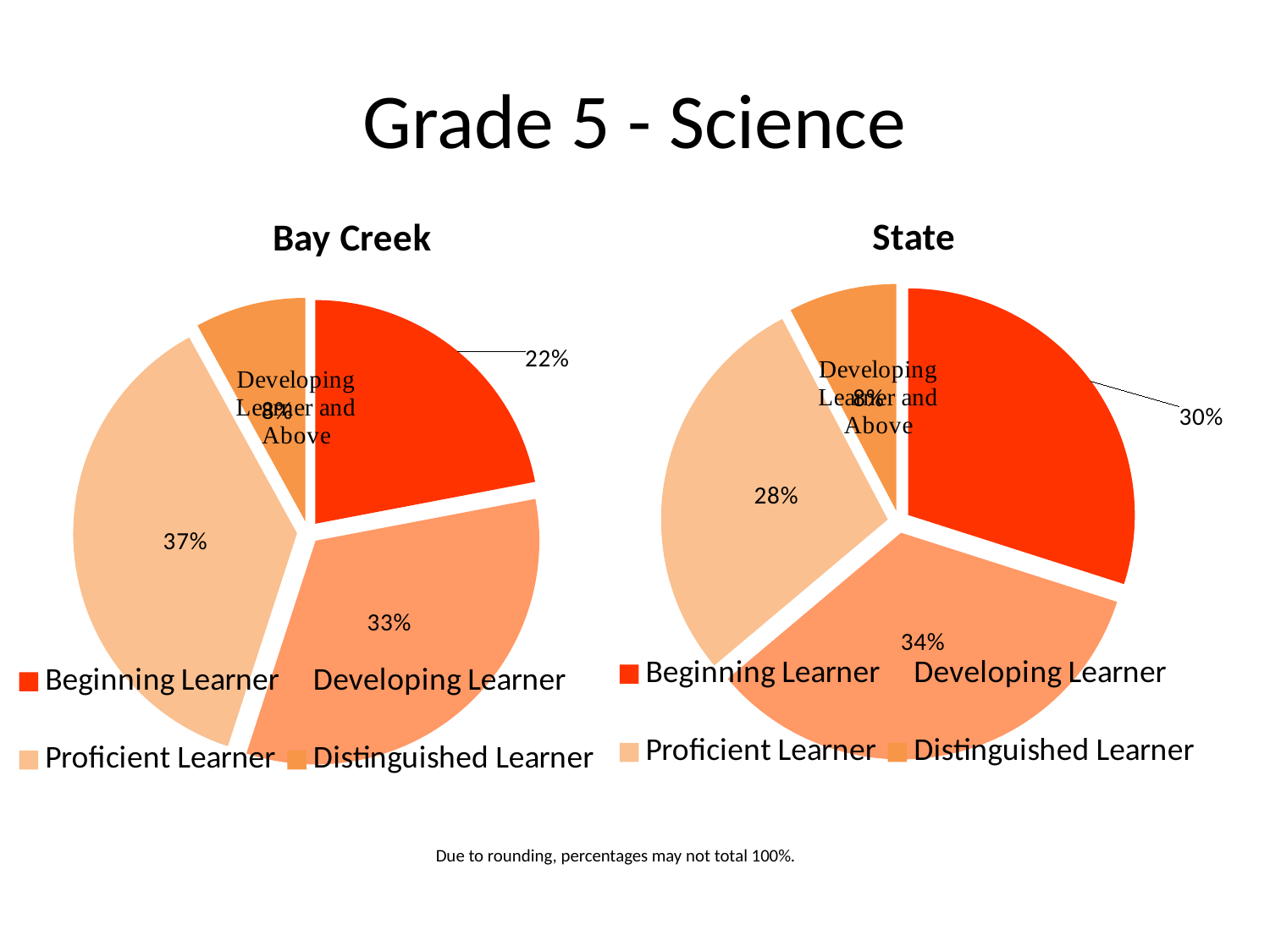
In the Bay Creek chart, what percentage is shown for Beginning Learner? 22% In the State chart, which category has the largest slice? Developing Learner In the Bay Creek chart, what percentage is shown for Proficient Learner? 37% In the State chart, what percentage is shown for Beginning Learner? 30% In the State chart, which category has the smallest slice? Distinguished Learner In the State chart, what percentage is shown for Developing Learner? 34% What is the title of the chart on the left? Bay Creek Which is larger: the Beginning Learner share in the Bay Creek chart or in the State chart? State In the Bay Creek chart, what is the difference between the Proficient Learner and Beginning Learner percentages? 15% What type of chart is the State chart? Pie chart How many categories does the legend of the Bay Creek chart list? 4 In the Bay Creek chart, which category has the largest slice? Proficient Learner